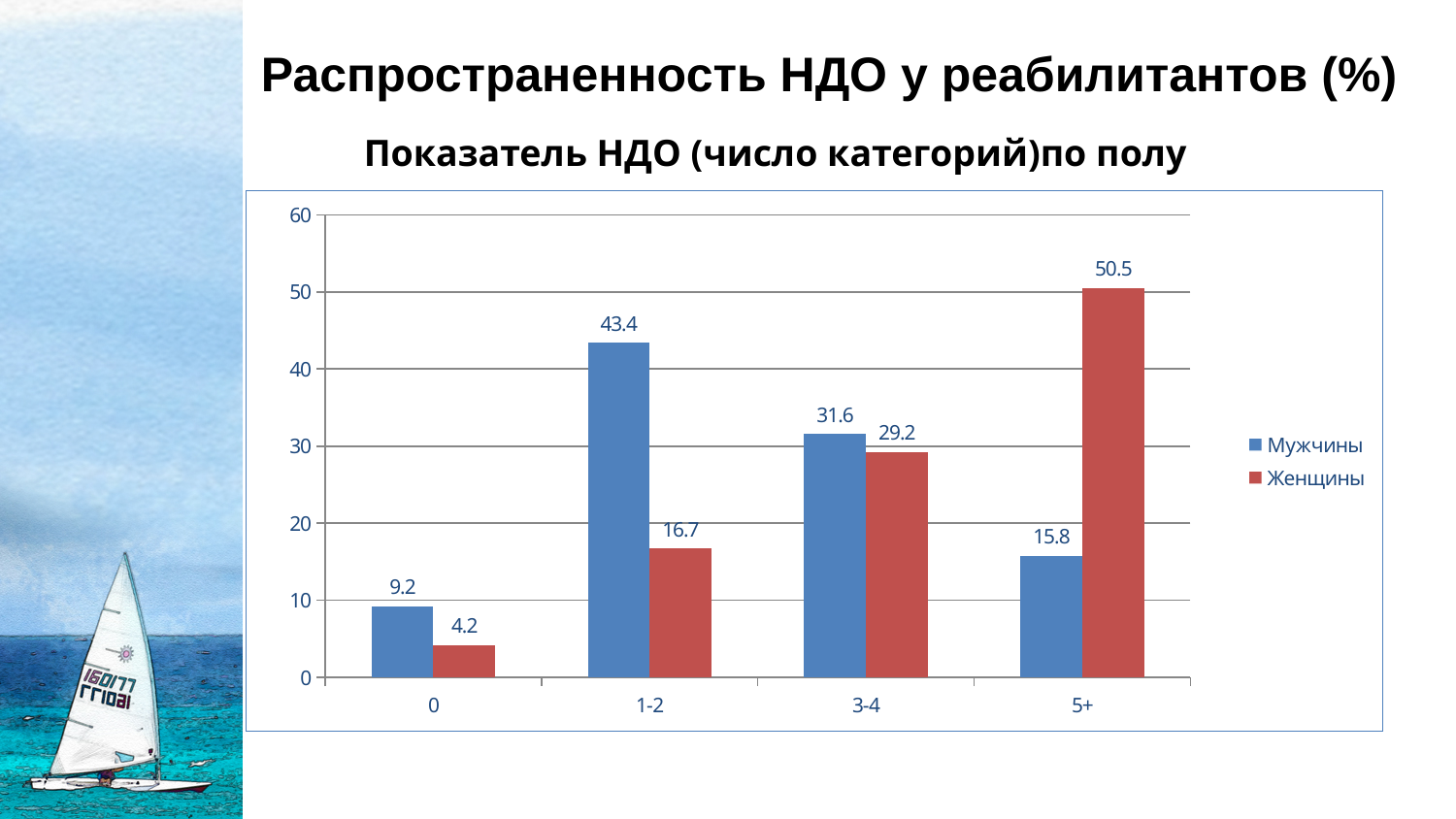
How many series does the legend list? 2 What is the value for Женщины in the 0 category? 4.2 Which category has the lowest value for Женщины? 0 Which category has the highest value for Мужчины? 1-2 What is the value for Мужчины in the 1-2 category? 43.4 How many categories are shown on the x axis? 4 Is the value for Мужчины in the 3-4 category greater or less than 30? greater What is the value for Женщины in the 5+ category? 50.5 What is the title of the chart? Показатель НДО (число категорий)по полу Which is larger in the 5+ category, Мужчины or Женщины? Женщины What is the difference between Мужчины and Женщины in the 3-4 category? 2.4 What kind of chart is shown on the slide? bar chart